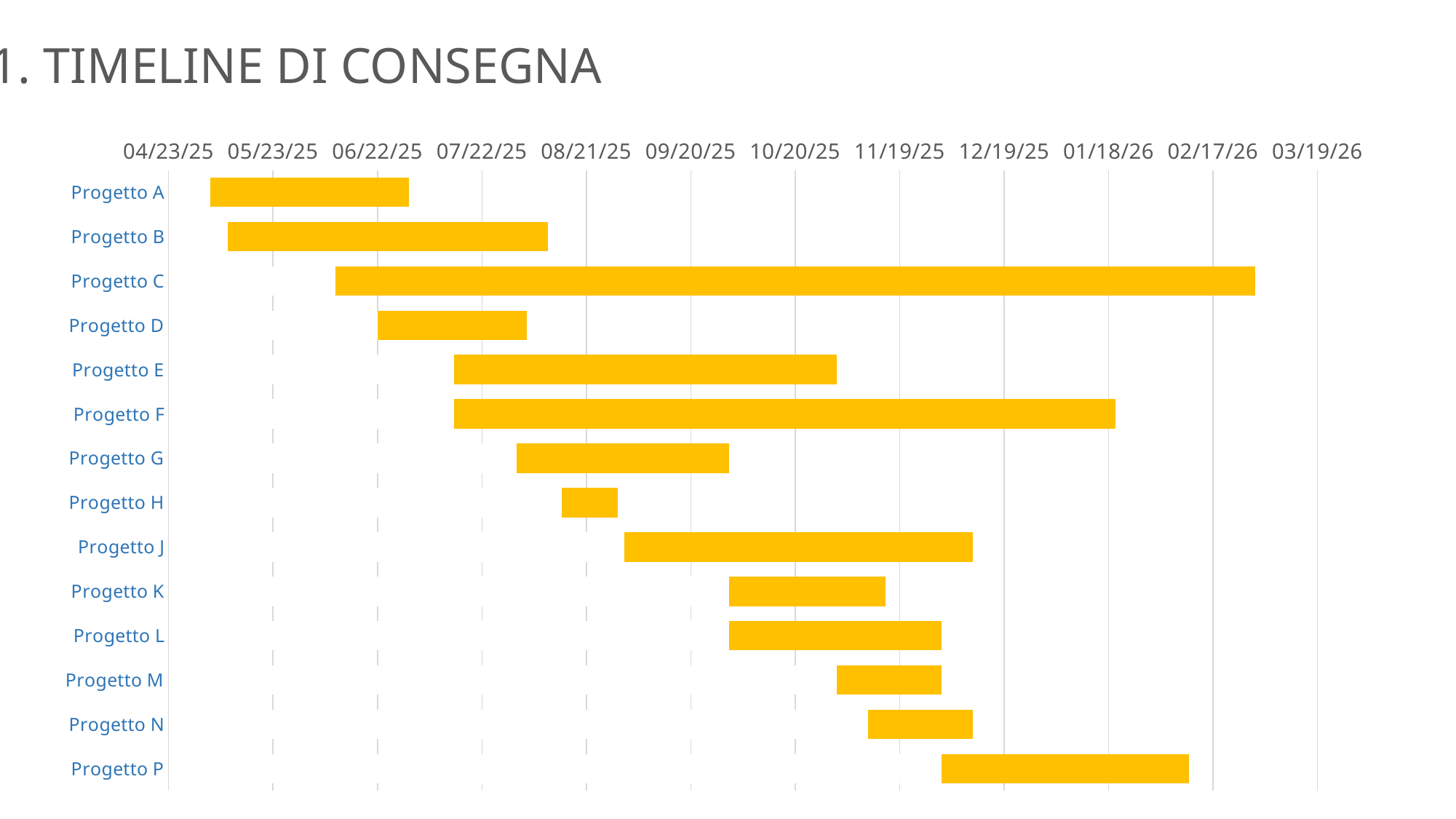
Which project has the shortest bar on the timeline? Progetto H Does Progetto A start before or after 05/23/25? before Which project starts earliest on the timeline? Progetto A What kind of chart is shown on the slide? Bar chart (Gantt chart) What is the title of the slide containing the chart? 1. TIMELINE DI CONSEGNA Which project has the longest bar on the timeline? Progetto C Which bar is longer, Progetto B or Progetto D? Progetto B Which project ends latest on the timeline? Progetto C Does Progetto C end before or after 02/17/26? after How many projects are listed on the chart? 14 Which bar is longer, Progetto E or Progetto G? Progetto E Does Progetto P end before or after 02/17/26? before